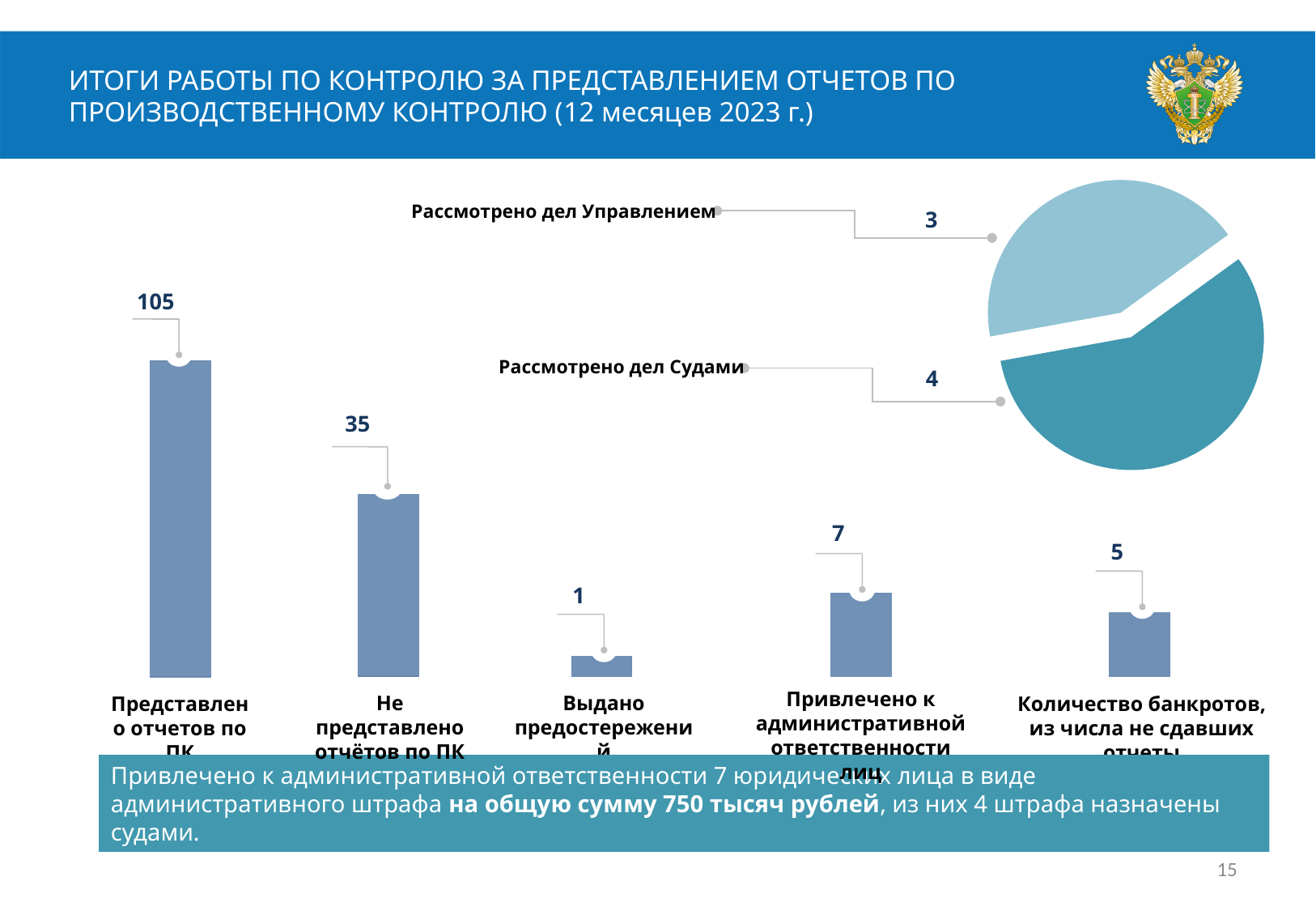
What kind of chart is shown in the top right of the slide? Pie chart In the bar chart, which category has the lowest value? Выдано предостережений In the bar chart, what is the value for «Выдано предостережений»? 1 In the bar chart, which category has the highest value? Представлено отчетов по ПК In the pie chart, what is the value for «Рассмотрено дел Судами»? 4 In the bar chart, what is the value for «Не представлено отчётов по ПК»? 35 In the bar chart, what is the value for «Количество банкротов, из числа не сдавших отчеты»? 5 In the bar chart, what is the value for «Представлено отчетов по ПК»? 105 In the bar chart, what is the difference between «Представлено отчетов по ПК» and «Не представлено отчётов по ПК»? 70 In the pie chart, what is the value for «Рассмотрено дел Управлением»? 3 In the bar chart, which is larger: «Привлечено к административной ответственности лиц» or «Количество банкротов, из числа не сдавших отчеты»? Привлечено к административной ответственности лиц How many categories does the bar chart show? 5